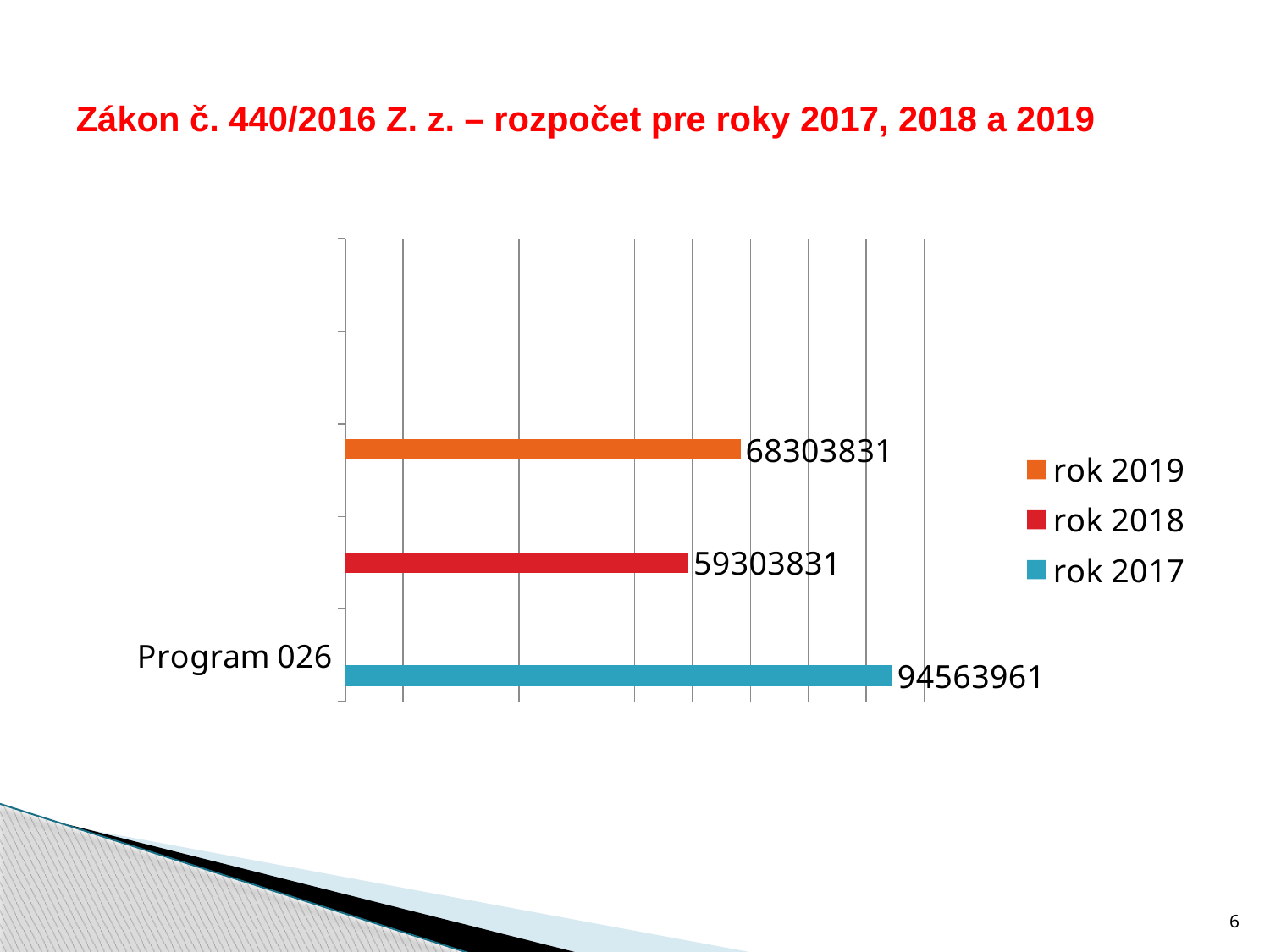
What is the value for rok 2017 for Program 026? 94563961 What is the difference between the rok 2017 and rok 2019 values for Program 026? 26260130 What is the value for rok 2018 for Program 026? 59303831 What is the value for rok 2019 for Program 026? 68303831 What kind of chart is shown on the slide? bar chart Which year has the lowest value for Program 026? rok 2018 What is the difference between the rok 2019 and rok 2018 values for Program 026? 9000000 How many series does the legend list? 3 What colour is the bar for rok 2017? blue How many categories are shown on the category axis? 1 Which is larger for Program 026, the rok 2018 value or the rok 2019 value? rok 2019 Which year has the highest value for Program 026? rok 2017